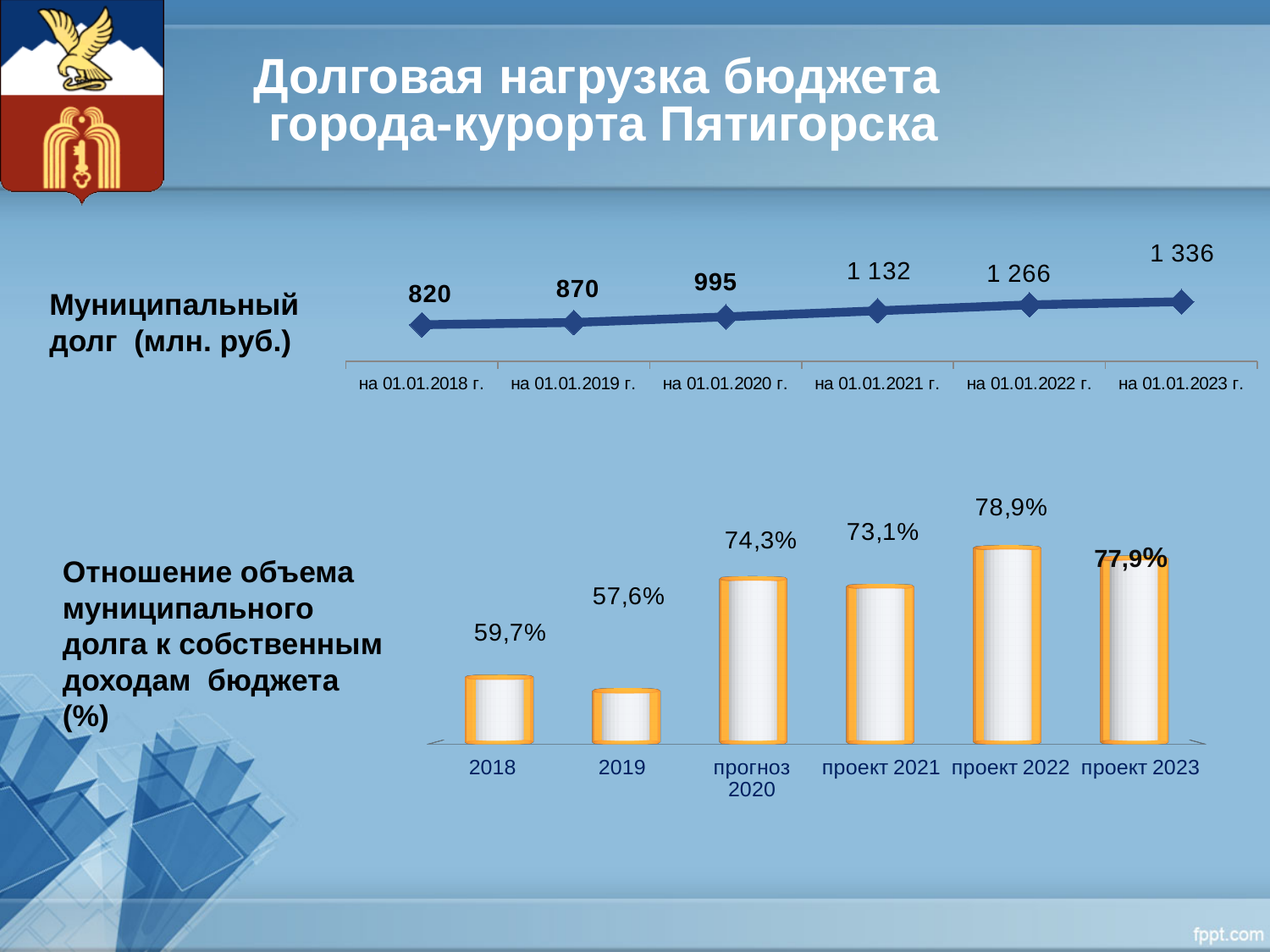
In the bottom chart (Отношение объема муниципального долга к собственным доходам бюджета, %), what is the difference between the values for 2018 and 2019? 2,1% In the top chart (Муниципальный долг, млн. руб.), what is the difference between the values for на 01.01.2022 г. and на 01.01.2021 г.? 134 What kind of chart is the top chart (Муниципальный долг, млн. руб.)? line chart In the bottom chart (Отношение объема муниципального долга к собственным доходам бюджета, %), what is the value for 2019? 57,6% In the bottom chart (Отношение объема муниципального долга к собственным доходам бюджета, %), which is larger: the value for прогноз 2020 or проект 2021? прогноз 2020 In the bottom chart (Отношение объема муниципального долга к собственным доходам бюджета, %), which category has the highest value? проект 2022 In the top chart (Муниципальный долг, млн. руб.), do the values rise or fall from left to right? rise What kind of chart is the bottom chart (Отношение объема муниципального долга к собственным доходам бюджета, %)? bar chart In the top chart (Муниципальный долг, млн. руб.), what is the value for на 01.01.2020 г.? 995 How many data points are plotted in the top chart (Муниципальный долг, млн. руб.)? 6 In the top chart (Муниципальный долг, млн. руб.), what is the value for на 01.01.2023 г.? 1 336 In the top chart (Муниципальный долг, млн. руб.), which date has the lowest value? на 01.01.2018 г.